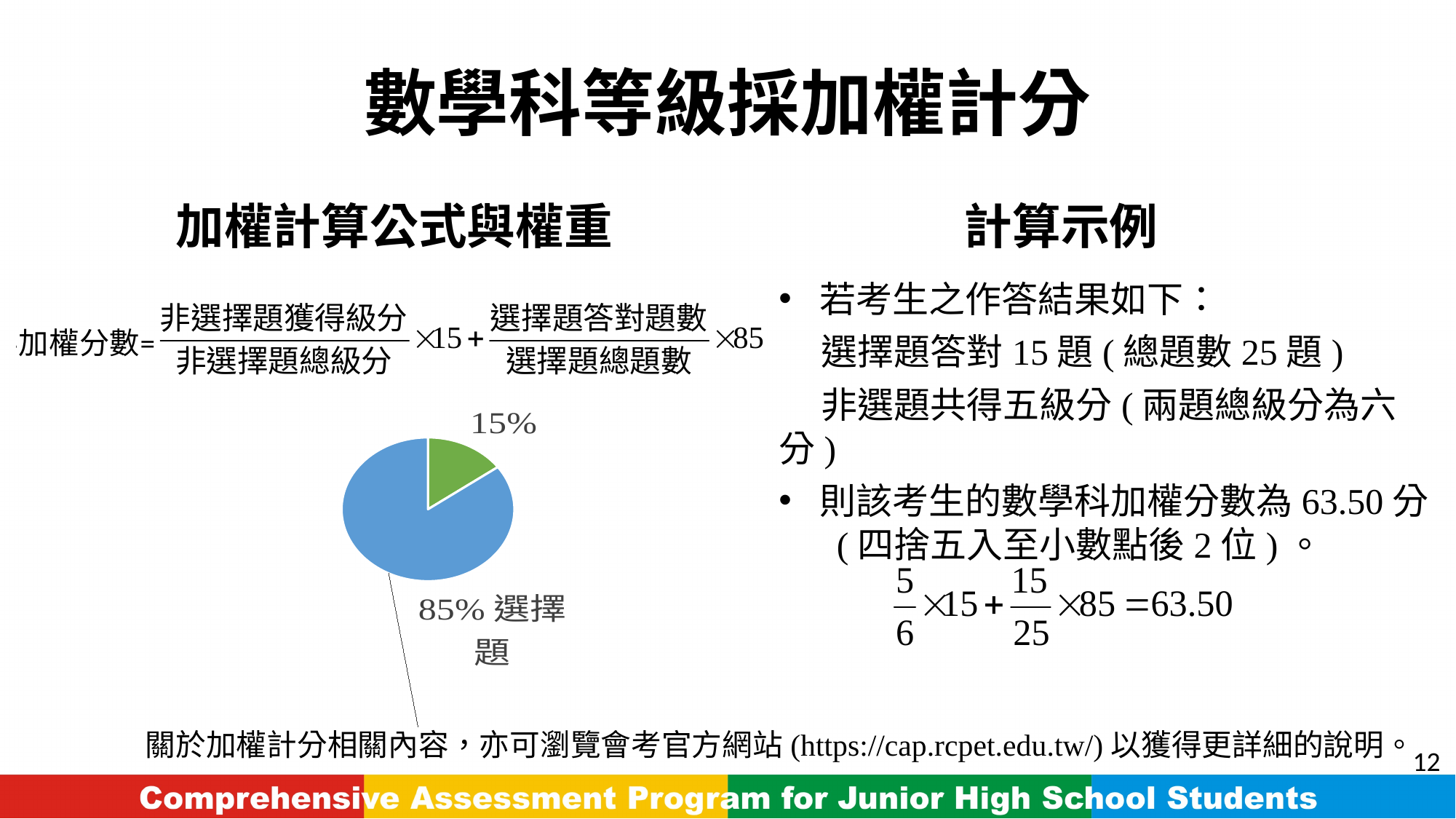
Is the share for 選擇題 greater or less than 50%? greater Is the 選擇題 slice larger or smaller than the other slice? larger Which slice of the pie chart is the largest? 選擇題 How many slices does the pie chart have? 2 What colour is the 選擇題 slice in the pie chart? blue What percentage is shown on the smaller slice of the pie chart? 15% What kind of chart is shown on the slide? pie chart What colour is the 15% slice in the pie chart? green What share of the pie chart does 選擇題 take? 85% What is the difference in percentage points between the 85% slice and the 15% slice? 70 What do the two slice percentages of the pie chart add up to? 100%